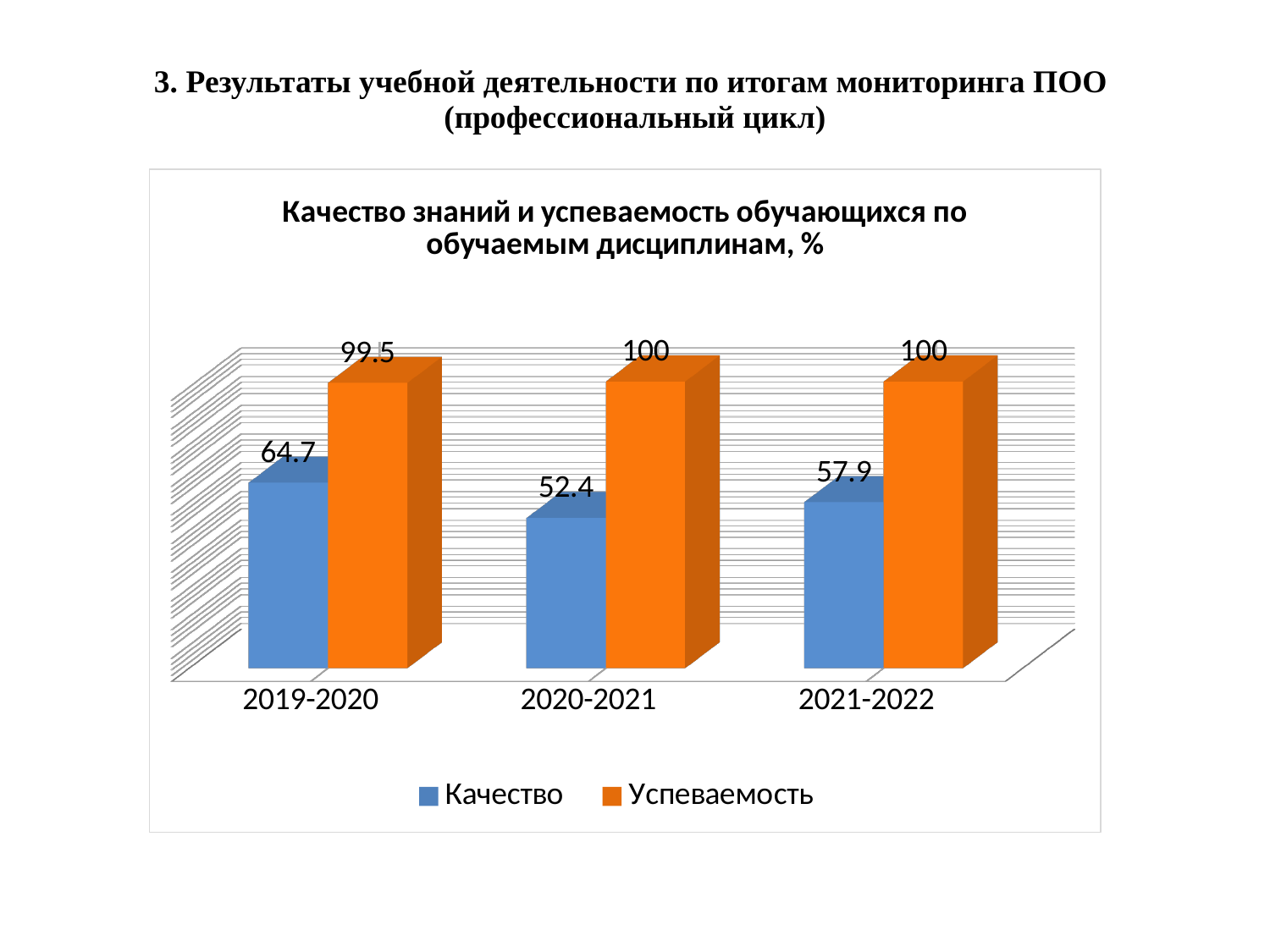
Which is larger: Качество in 2021-2022 or Качество in 2020-2021? Качество in 2021-2022 What is the value of Качество for 2021-2022? 57.9 What is the value of Успеваемость for 2020-2021? 100 Which series is shown in orange? Успеваемость In which year is Качество the highest? 2019-2020 In which year is Качество the lowest? 2020-2021 What is the value of Успеваемость for 2019-2020? 99.5 What is the difference between Качество in 2019-2020 and 2020-2021? 12.3 How many year categories are shown on the x axis? 3 What kind of chart is shown on the slide? Bar chart How many series does the legend list? 2 What is the value of Качество for 2019-2020? 64.7